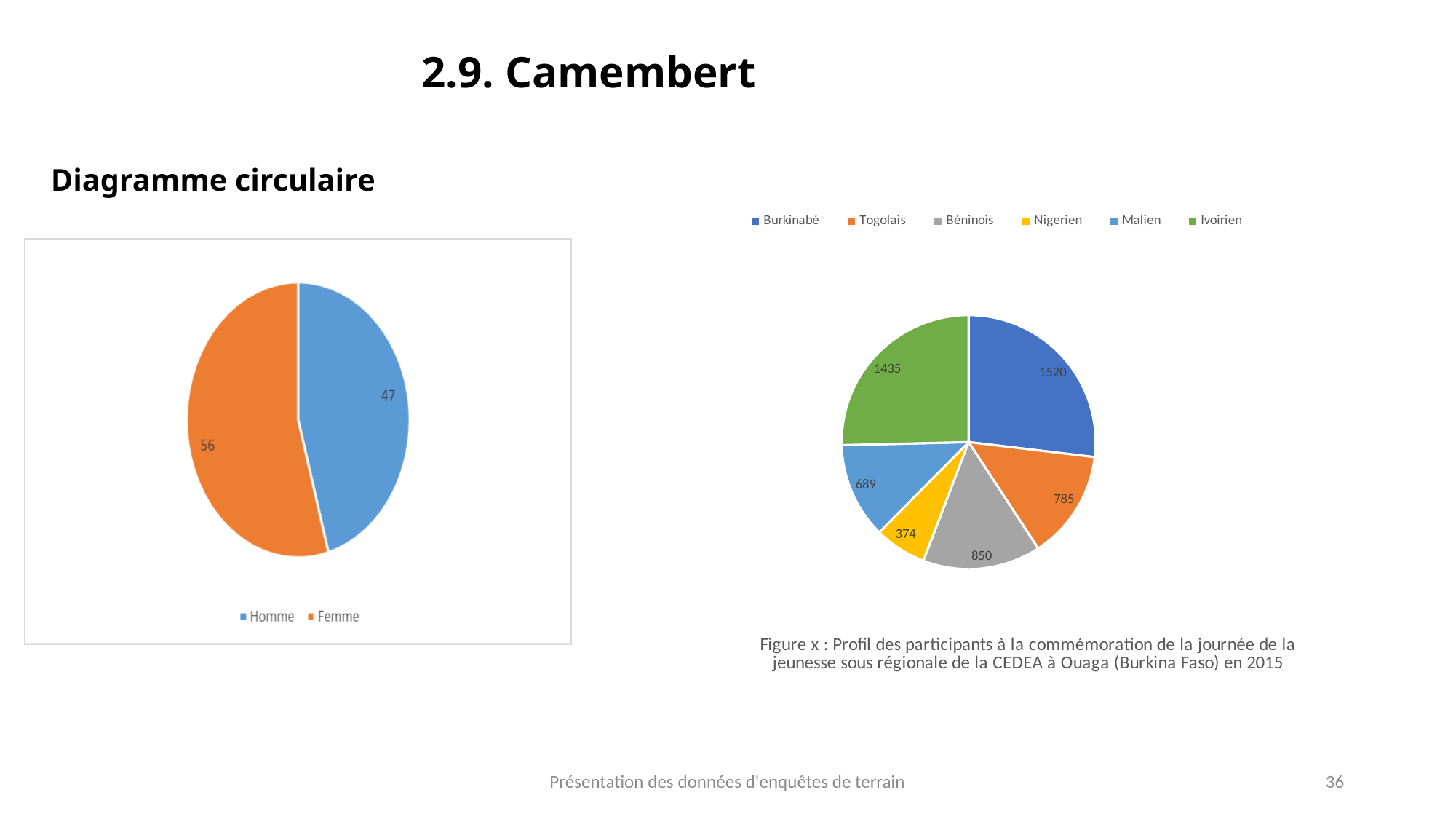
On the right pie chart, what is the value for Malien? 689 On the right pie chart, how many categories does the legend list? 6 On the left pie chart, what is the value for Femme? 56 On the right pie chart, which category has the largest value? Burkinabé On the right pie chart, which colour represents Ivoirien? Green On the right pie chart, what is the value for Burkinabé? 1520 On the right pie chart, which category has the smallest value? Nigerien On the right pie chart, what is the difference between the Béninois and Togolais values? 65 On the left pie chart, what is the difference between the Femme and Homme values? 9 What type of chart is shown on the left of the slide? Pie chart On the left pie chart, what is the value for Homme? 47 On the left pie chart, which category is larger, Homme or Femme? Femme